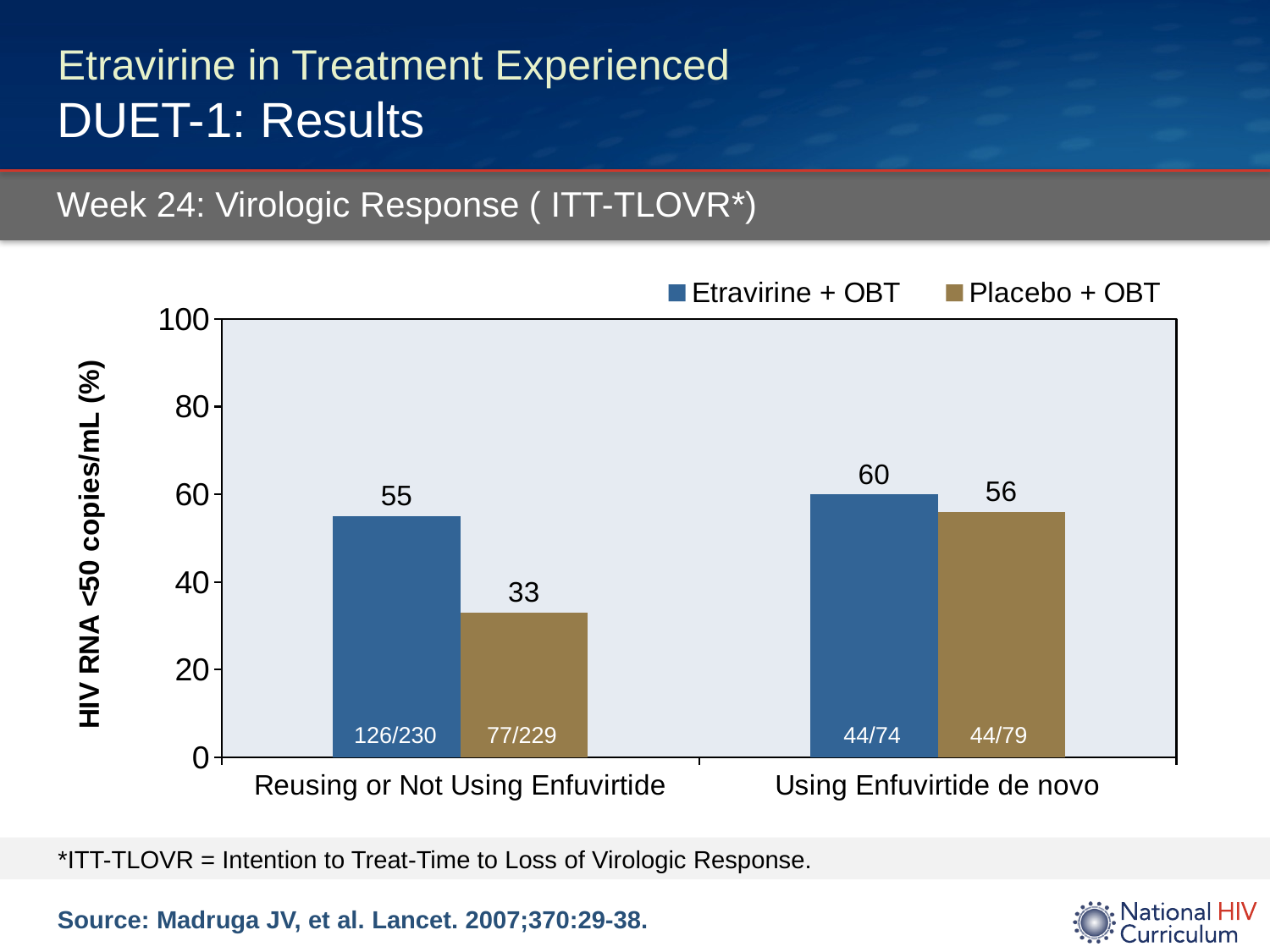
Which bar has the lowest value on the chart? Placebo + OBT, Reusing or Not Using Enfuvirtide Which bar has the highest value on the chart? Etravirine + OBT, Using Enfuvirtide de novo How many categories are shown on the x axis? 2 What is the value for Placebo + OBT in the Using Enfuvirtide de novo group? 56 What kind of chart is shown on the slide? Bar chart What is the difference between Etravirine + OBT and Placebo + OBT in the Using Enfuvirtide de novo group? 4 What is the value for Etravirine + OBT in the Reusing or Not Using Enfuvirtide group? 55 Which is larger in the Reusing or Not Using Enfuvirtide group: Etravirine + OBT or Placebo + OBT? Etravirine + OBT What is the value for Placebo + OBT in the Reusing or Not Using Enfuvirtide group? 33 What is the difference between Etravirine + OBT and Placebo + OBT in the Reusing or Not Using Enfuvirtide group? 22 What fraction is printed inside the Etravirine + OBT bar for the Reusing or Not Using Enfuvirtide group? 126/230 How many series does the legend list? 2